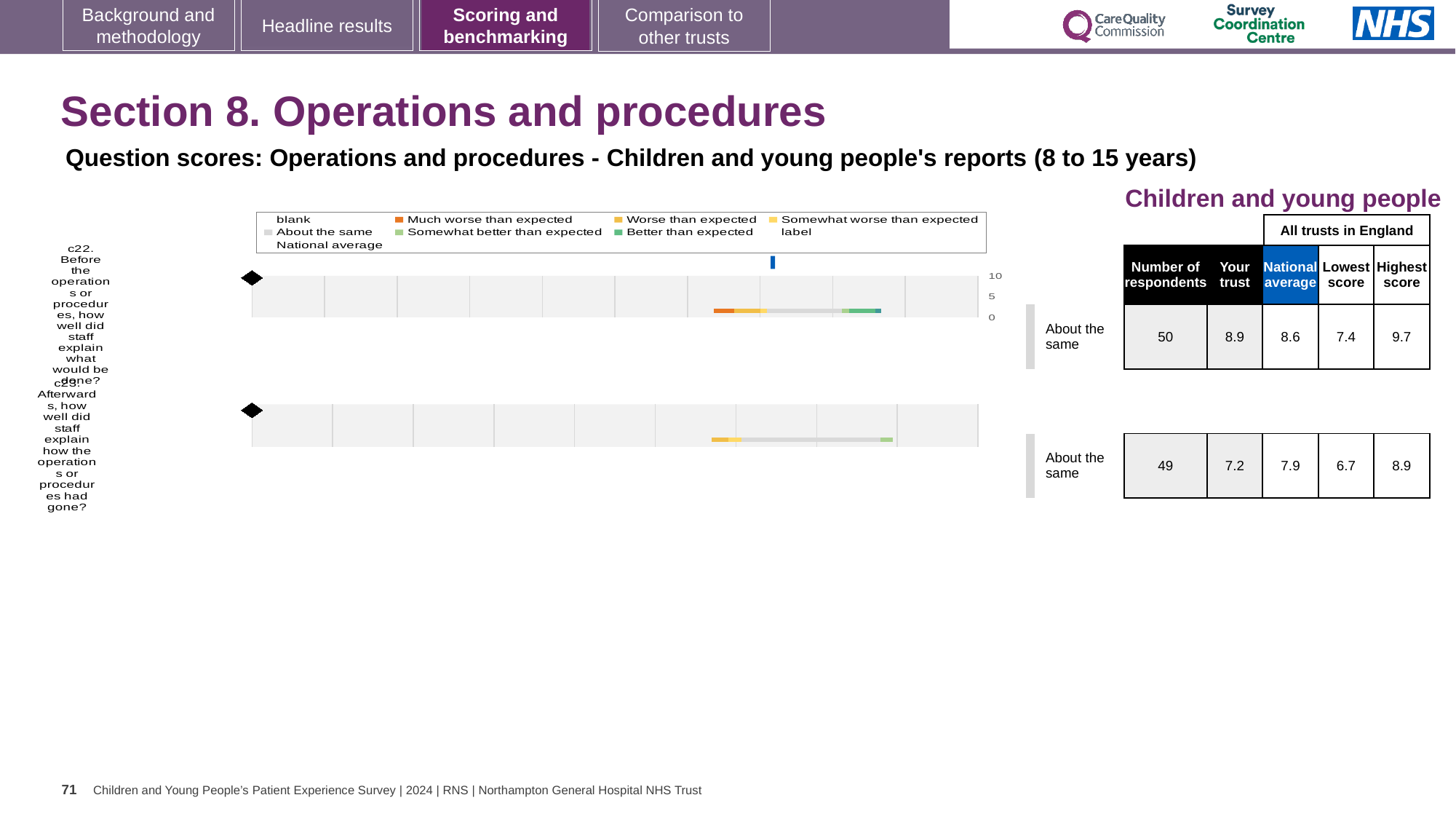
What is the national average score for question c23 (Afterwards, how well did staff explain how the operations or procedures had gone?)? 7.9 What colour represents 'Much worse than expected' in the chart legend? Orange What is the highest score among all trusts in England for question c23? 8.9 What is the 'Your trust' score for question c22 (Before the operations or procedures, how well did staff explain what would be done?)? 8.9 What is the difference between the highest and lowest scores for question c23? 2.2 Which question has the higher 'Your trust' score, c22 or c23? c22 How many respondents answered question c22? 50 What is the lowest score among all trusts in England for question c22? 7.4 What type of chart is used to show the question scores on this slide? Bar chart For question c22, how much higher is the 'Your trust' score than the national average? 0.3 Which question has more respondents, c22 or c23? c22 How many questions are plotted in the chart on this slide? 2